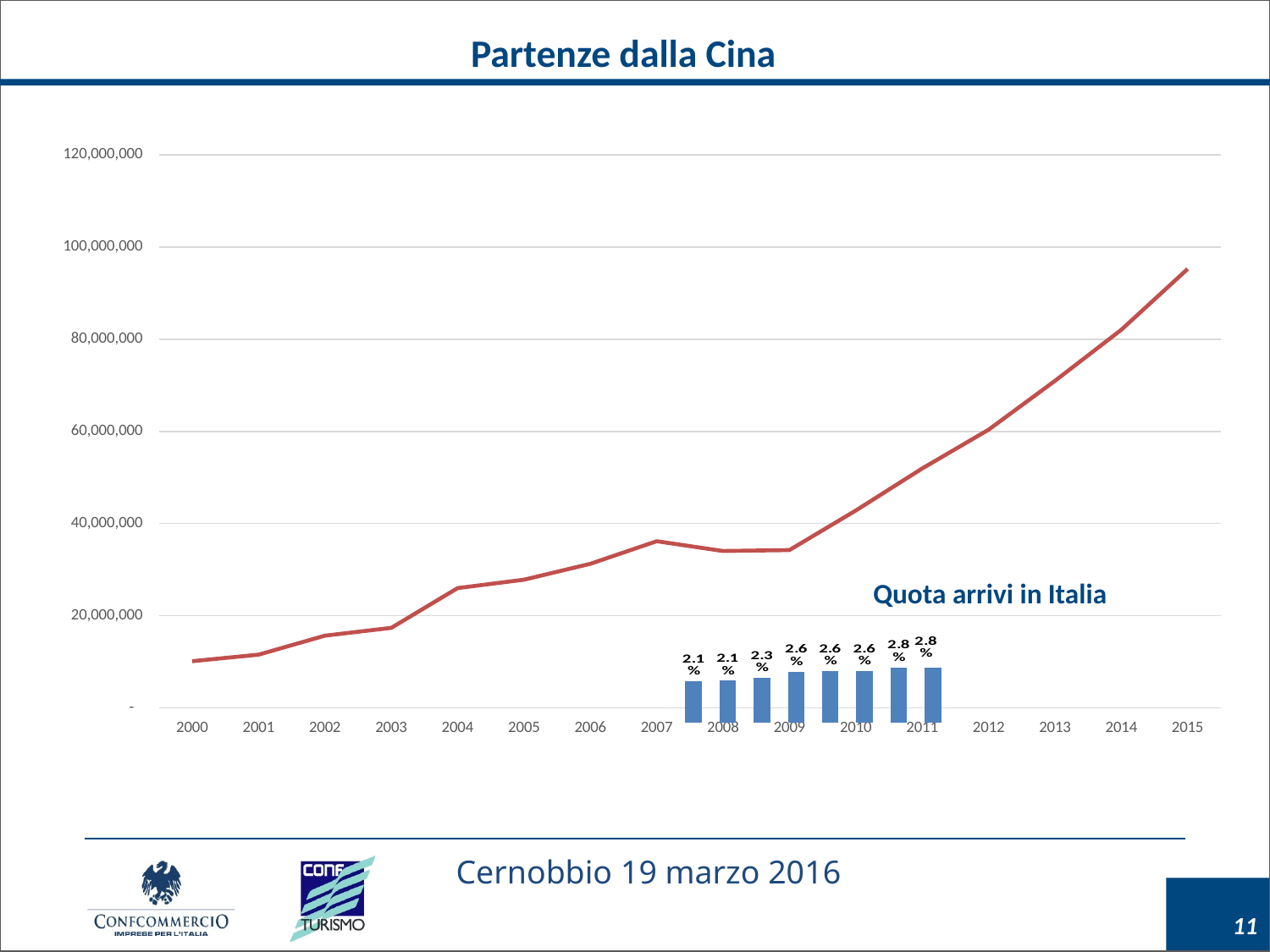
In the 'Partenze dalla Cina' line chart, which year has the lowest value? 2000 In the 'Partenze dalla Cina' line chart, is the value for 2007 greater or less than 40,000,000? less What type of chart is the main chart titled 'Partenze dalla Cina'? line chart In the 'Partenze dalla Cina' line chart, is the value for 2011 greater or less than 40,000,000? greater In the inset 'Quota arrivi in Italia' bar chart, how many bars are shown? 8 In the 'Partenze dalla Cina' line chart, is the value for 2015 greater or less than 80,000,000? greater In the inset 'Quota arrivi in Italia' bar chart, what is the highest value shown? 2.8% In the inset 'Quota arrivi in Italia' bar chart, what is the difference between the highest value (2.8%) and the lowest value (2.1%)? 0.7% In the 'Partenze dalla Cina' line chart, which year has the highest value? 2015 In the 'Partenze dalla Cina' line chart, do the values generally rise or fall from 2000 to 2015? rise In the 'Partenze dalla Cina' line chart, how many years are shown on the x axis? 16